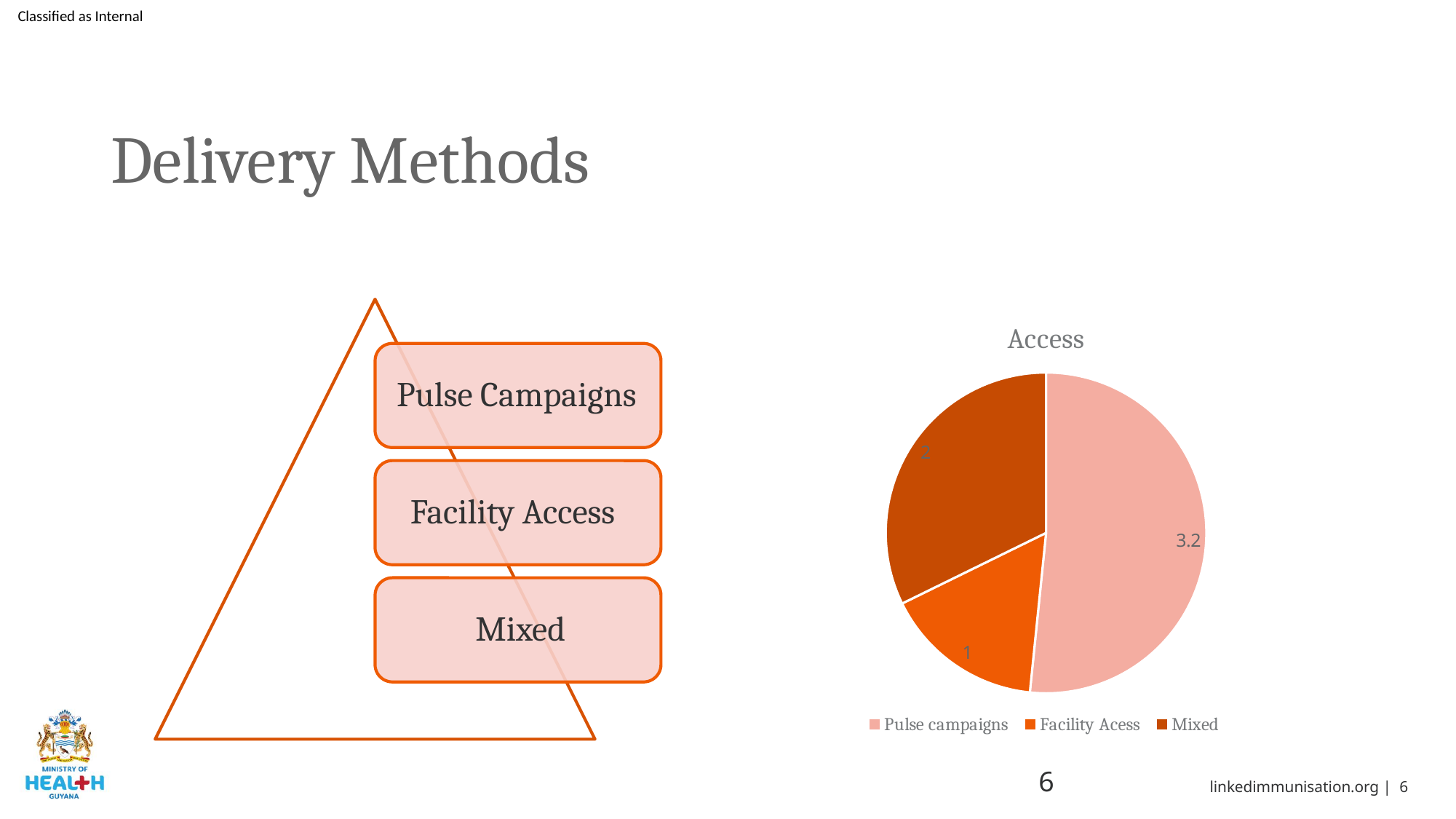
How many slices does the pie chart have? 3 What is the title of the pie chart? Access What is the value for Pulse campaigns in the pie chart? 3.2 What is the value for Facility Acess in the pie chart? 1 Which is larger, the value for Mixed or the value for Facility Acess? Mixed Which category has the smallest slice in the pie chart? Facility Acess What is the value for Mixed in the pie chart? 2 How many entries does the legend of the pie chart list? 3 What kind of chart is shown on the slide? Pie chart Which legend entry is shown in the lightest colour in the pie chart? Pulse campaigns Which category has the largest slice in the pie chart? Pulse campaigns What is the difference between the values for Pulse campaigns and Mixed? 1.2